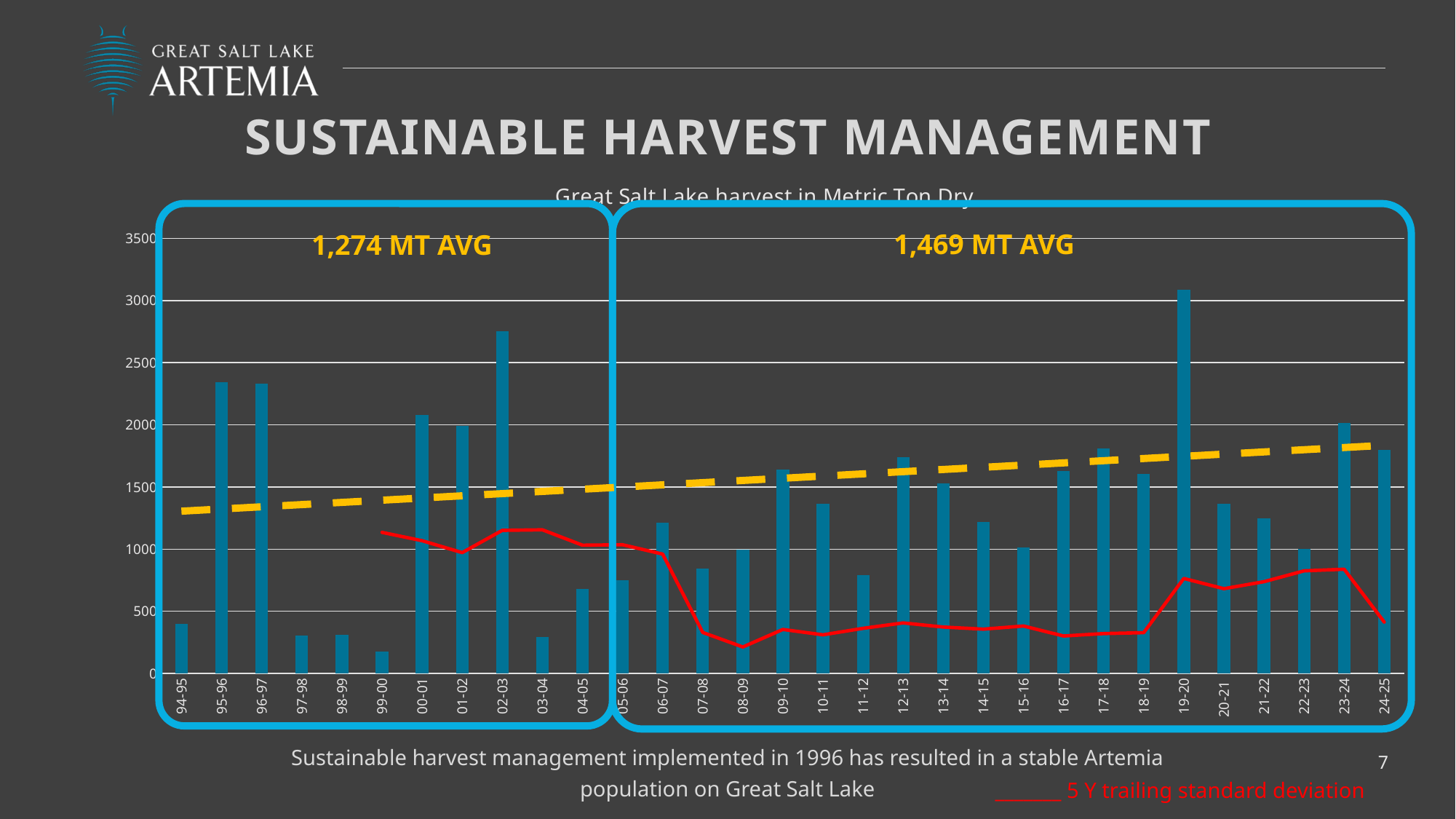
What does the red line on the chart represent? 5 Y trailing standard deviation What is the title of the chart? Great Salt Lake harvest in Metric Ton Dry Is the harvest value for 19-20 greater or less than 3000? greater How many harvest seasons are shown on the x axis? 31 Is the harvest value for 02-03 greater or less than 2500? greater Which season has the larger harvest bar, 02-03 or 23-24? 02-03 Is the harvest value for 94-95 greater or less than 500? less Which season has the lowest harvest bar? 99-00 What kind of chart is used to show the harvest values? bar chart What average harvest is printed for the earlier (left) period? 1,274 MT AVG What average harvest is printed for the later (right) period? 1,469 MT AVG Which season has the highest harvest bar? 19-20